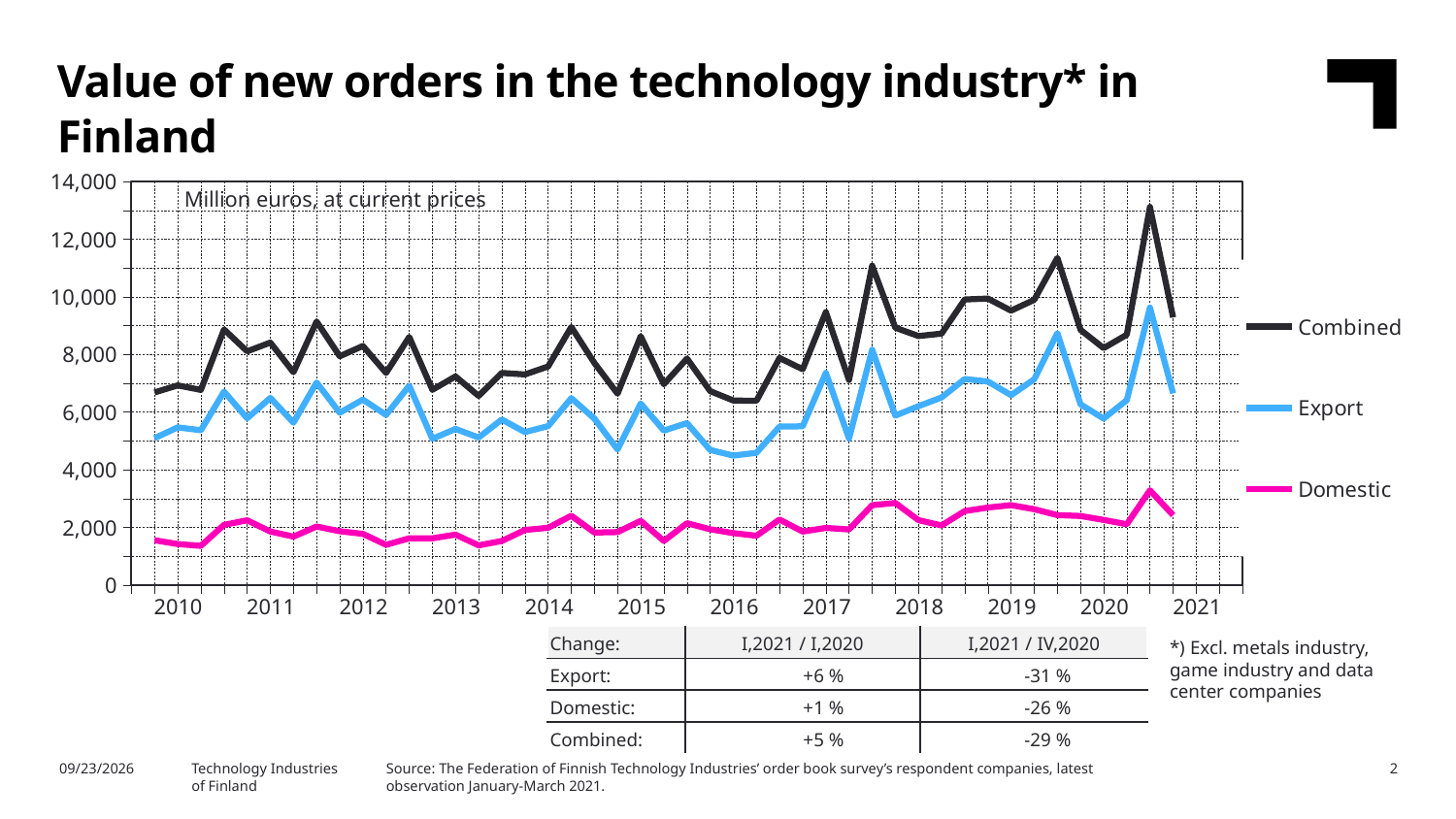
Which series has the highest values throughout the chart? Combined Which series has the lowest values throughout the chart? Domestic Does the Combined line generally rise or fall from 2016 to 2019? rise Which is larger in 2020, the Export series or the Domestic series? Export What unit is stated inside the chart area? Million euros, at current prices Is the peak value of the Combined series in late 2020 greater or less than 12,000? greater How many years are labelled on the x axis? 12 How many series does the legend list? 3 Is the value for Export during 2016 greater or less than 6,000? less Is the peak value of the Export series in late 2020 greater or less than 8,000? greater What kind of chart is shown on the slide? Line chart